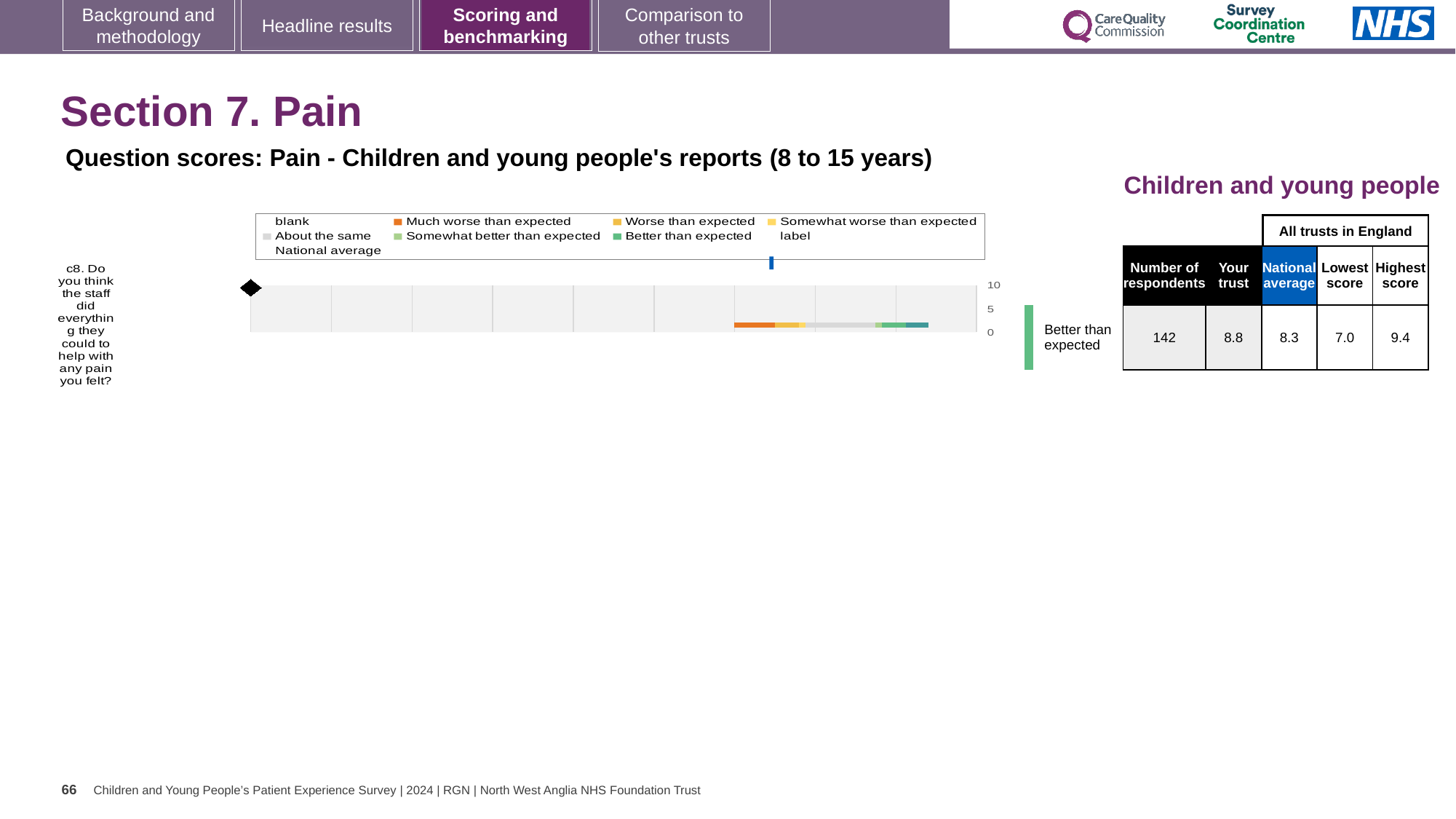
In the table next to the chart, what is the score for Your trust for question c8? 8.8 Which legend entry is shown in orange on the chart? Much worse than expected In the table next to the chart, what is the Highest score among all trusts in England for question c8? 9.4 According to the table next to the chart, what is the difference between the Highest score and the Lowest score for question c8? 2.4 In the table next to the chart, what is the Lowest score among all trusts in England for question c8? 7.0 In the table next to the chart, what is the National average score for question c8? 8.3 What is the highest value shown on the chart's numeric axis? 10 What kind of chart is shown on the slide? bar chart How many question categories are plotted on the chart? 1 In the table next to the chart, how many respondents answered question c8? 142 According to the table next to the chart, which is larger for question c8: the Your trust score or the National average? Your trust What benchmark category label is shown beside the chart for question c8? Better than expected